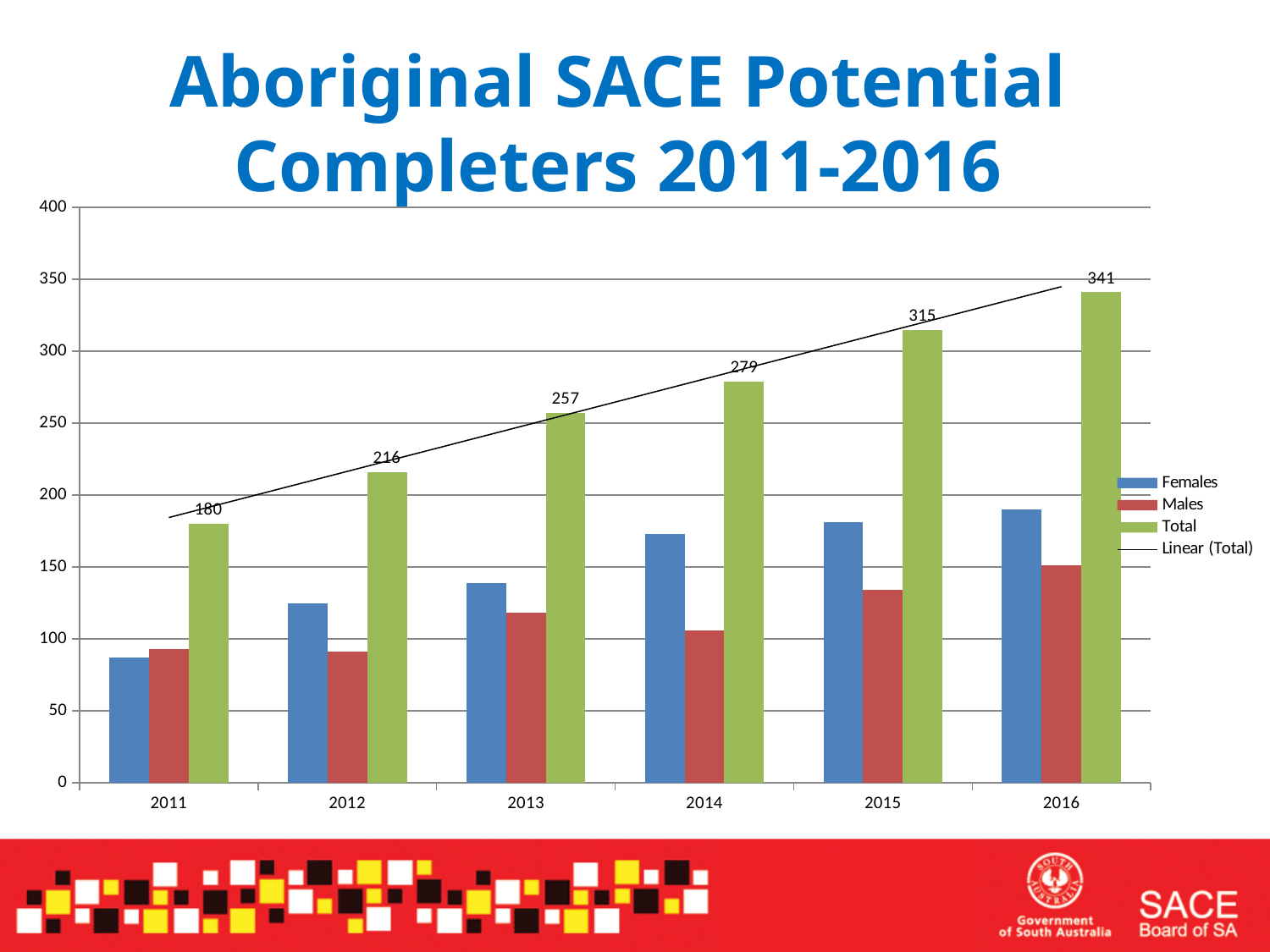
What is the difference between the Total for 2016 and the Total for 2011? 161 How many years are shown on the x axis? 6 Which year has the highest Total? 2016 Is the Females value for 2011 greater or less than 100? less What is the difference between the Total for 2015 and the Total for 2014? 36 Is the Females value for 2016 greater or less than 150? greater What is the Total value for 2016? 341 In 2014, which is larger, the Females value or the Males value? Females What is the Total value for 2013? 257 What is the Total value for 2011? 180 Which year has the lowest Total? 2011 How many entries does the legend list? 4